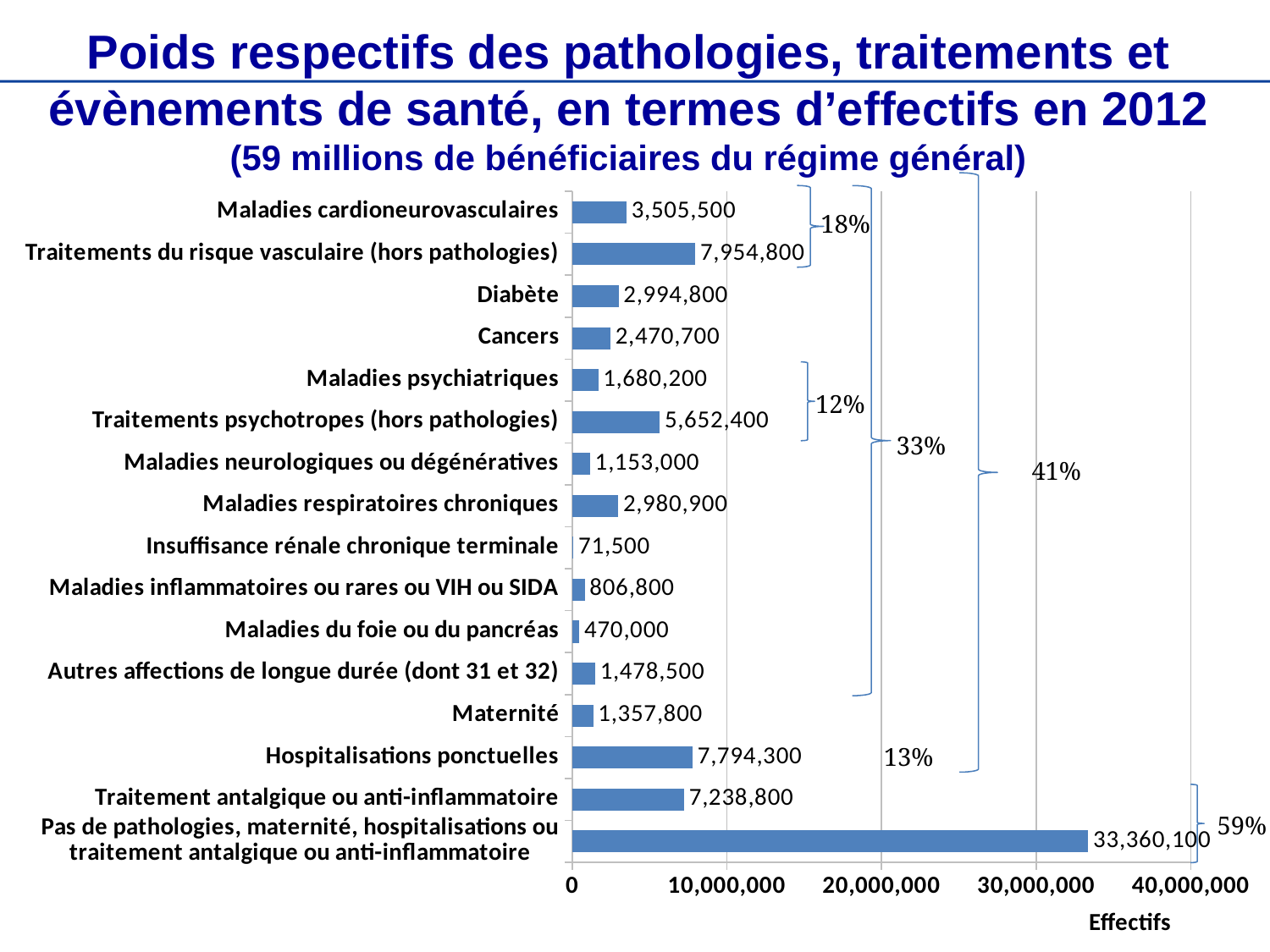
What is the difference between Traitements du risque vasculaire (hors pathologies) and Hospitalisations ponctuelles? 160,500 What is the value for Diabète? 2,994,800 Is the value for Pas de pathologies, maternité, hospitalisations ou traitement antalgique ou anti-inflammatoire greater or less than 30,000,000? greater What kind of chart is shown on the slide? bar chart Which category has the highest value? Pas de pathologies, maternité, hospitalisations ou traitement antalgique ou anti-inflammatoire What is the difference between Diabète and Cancers? 524,100 What is the value for Insuffisance rénale chronique terminale? 71,500 What is the value for Hospitalisations ponctuelles? 7,794,300 What is the label of the horizontal axis? Effectifs How many categories are shown in the chart? 16 Which is larger, Traitements psychotropes (hors pathologies) or Maladies psychiatriques? Traitements psychotropes (hors pathologies) Which category has the lowest value? Insuffisance rénale chronique terminale